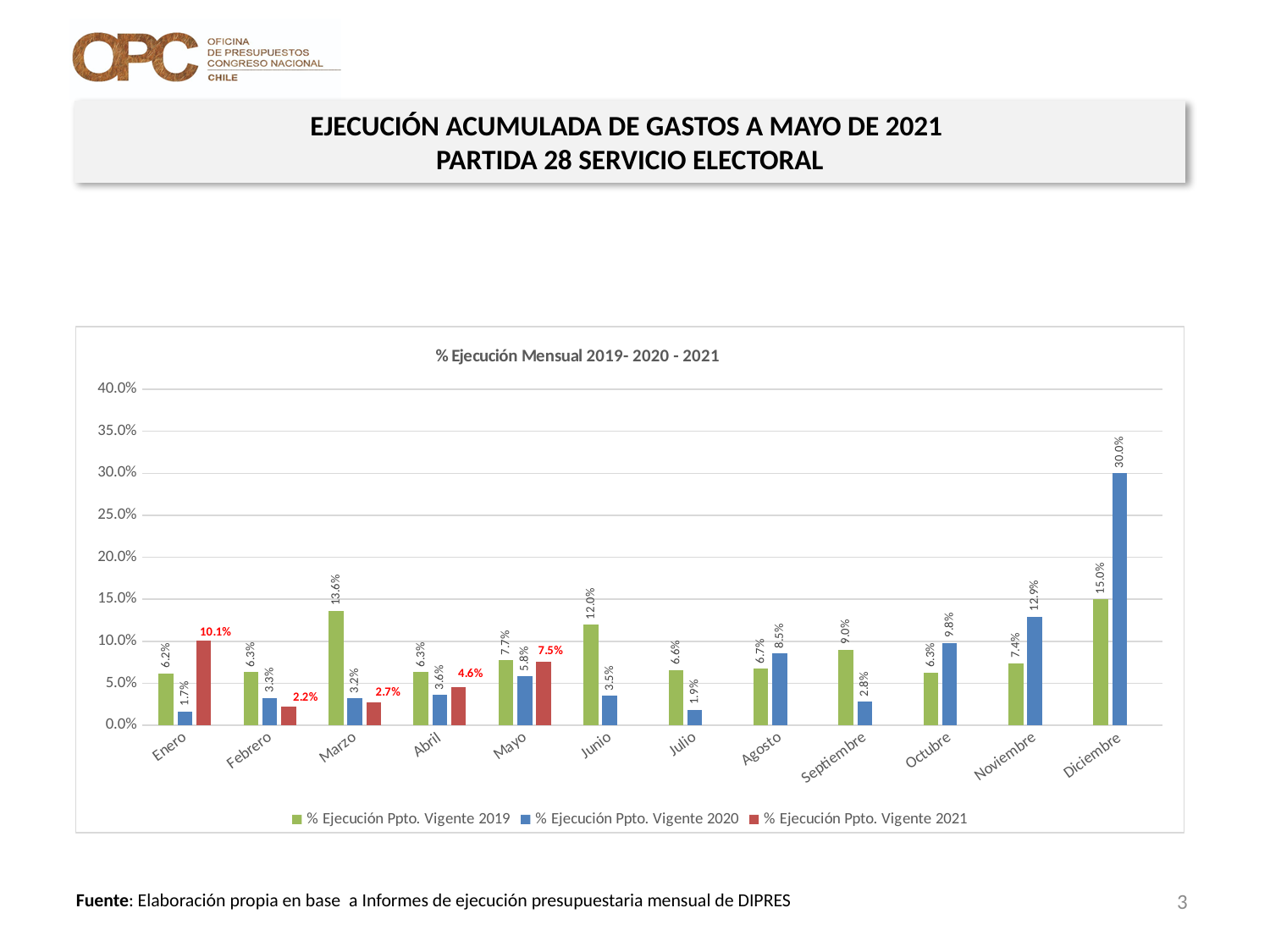
What type of chart is shown on the slide? Bar chart Which month has the highest value for % Ejecución Ppto. Vigente 2020? Diciembre What is the value for % Ejecución Ppto. Vigente 2019 in Marzo? 13.6% How many series does the legend list? 3 What is the difference between the 2019 and 2020 values in Diciembre? 15.0% What is the value for % Ejecución Ppto. Vigente 2021 in Enero? 10.1% What is the title of the chart? % Ejecución Mensual 2019- 2020 - 2021 How many months are shown on the x axis? 12 In Mayo, which is larger: the 2019 value or the 2021 value? 2019 value (7.7%) Is the value for % Ejecución Ppto. Vigente 2020 in Noviembre greater or less than 10.0%? greater What is the value for % Ejecución Ppto. Vigente 2020 in Diciembre? 30.0% Which month has the lowest value for % Ejecución Ppto. Vigente 2021? Febrero